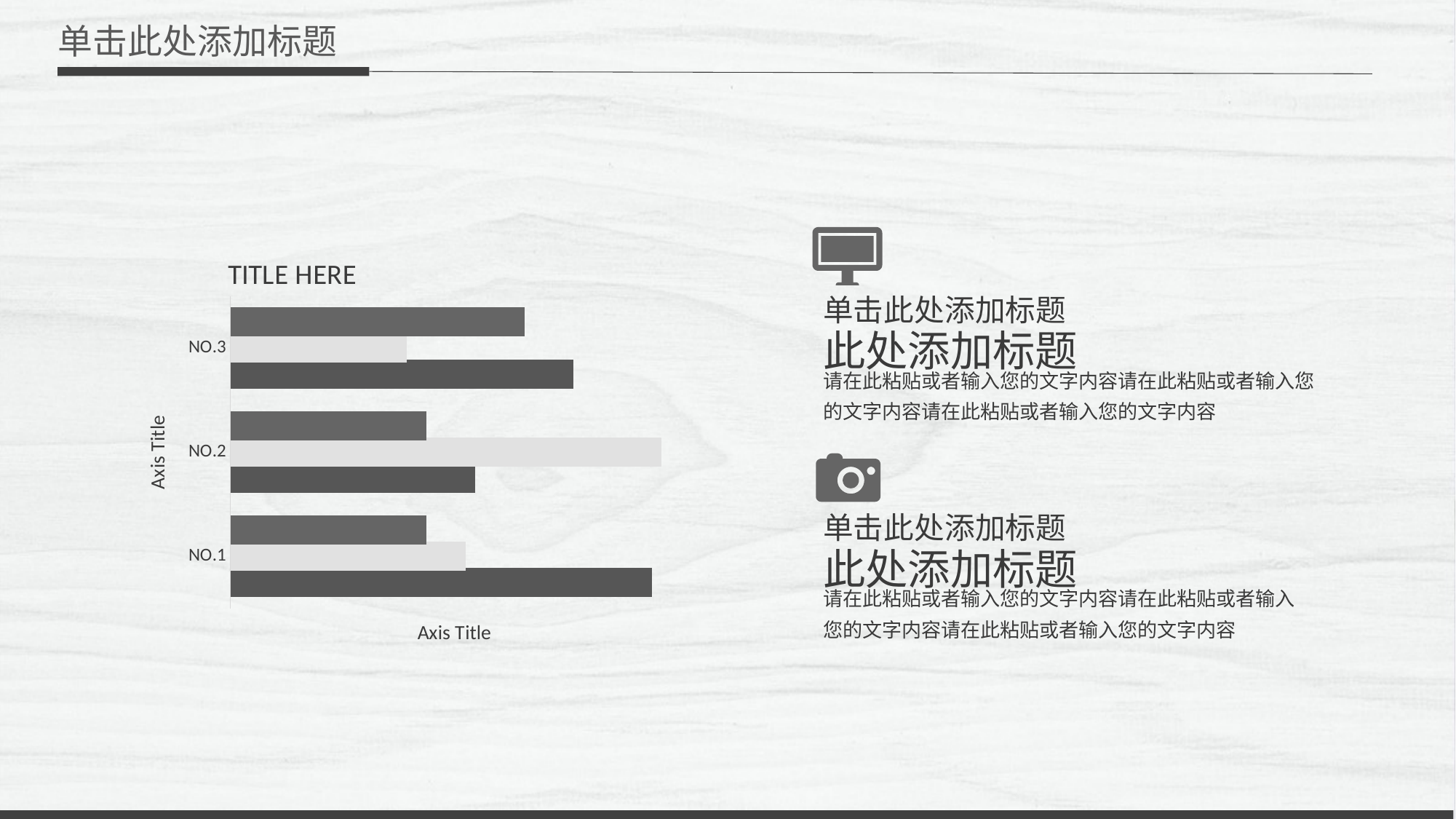
Which category has the longest light grey middle bar? NO.2 For category NO.3, which bar is longer: the light grey middle bar or the dark bottom bar? the dark bottom bar What kind of chart is shown on the slide? bar chart Which category has the shortest dark bottom bar? NO.2 What is the title of the chart? TITLE HERE Which category has the longest top bar? NO.3 What is the label of the horizontal axis of the chart? Axis Title Which category has the longest dark bottom bar? NO.1 How many categories are shown on the chart's vertical axis? 3 Which category has the shortest light grey middle bar? NO.3 How many bars are drawn for each category in the chart? 3 For category NO.2, which bar is longer: the light grey middle bar or the dark bottom bar? the light grey middle bar